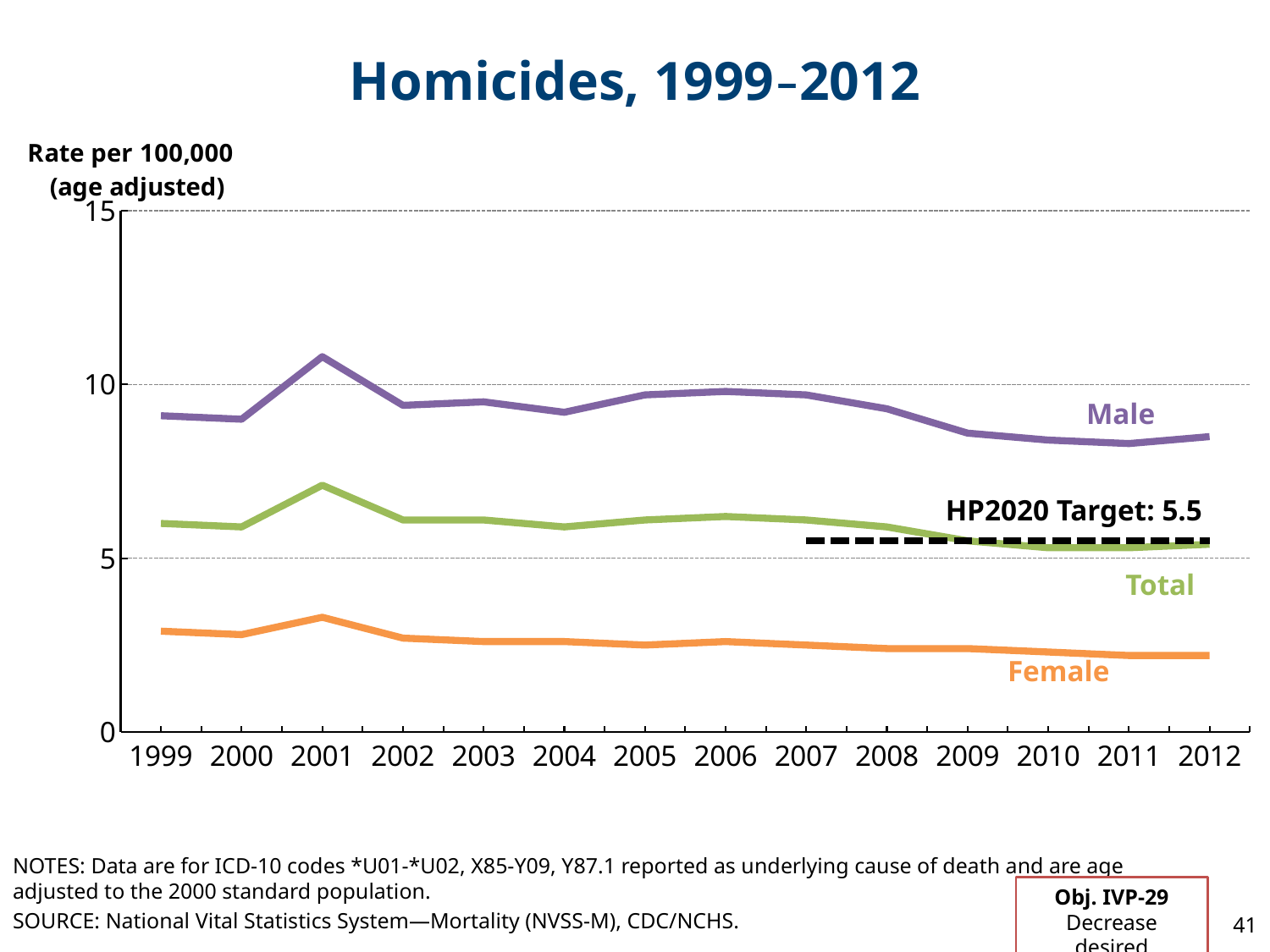
In which year does the Male rate reach its highest value? 2001 How many years are shown along the x axis? 14 Is the Female rate in 2006 greater or less than 5? less What is the HP2020 Target value shown on the chart? 5.5 In which year does the Female rate reach its highest value? 2001 What kind of chart is shown on the slide? line chart Does the Male rate rise or fall from 2006 to 2011? fall Which series has the lowest homicide rate across all years? Female Is the Male rate in 2012 greater or less than 10? less How many series are plotted on the chart? 4 Is the Male rate in 2001 greater or less than 10? greater Which series has the highest homicide rate across all years? Male